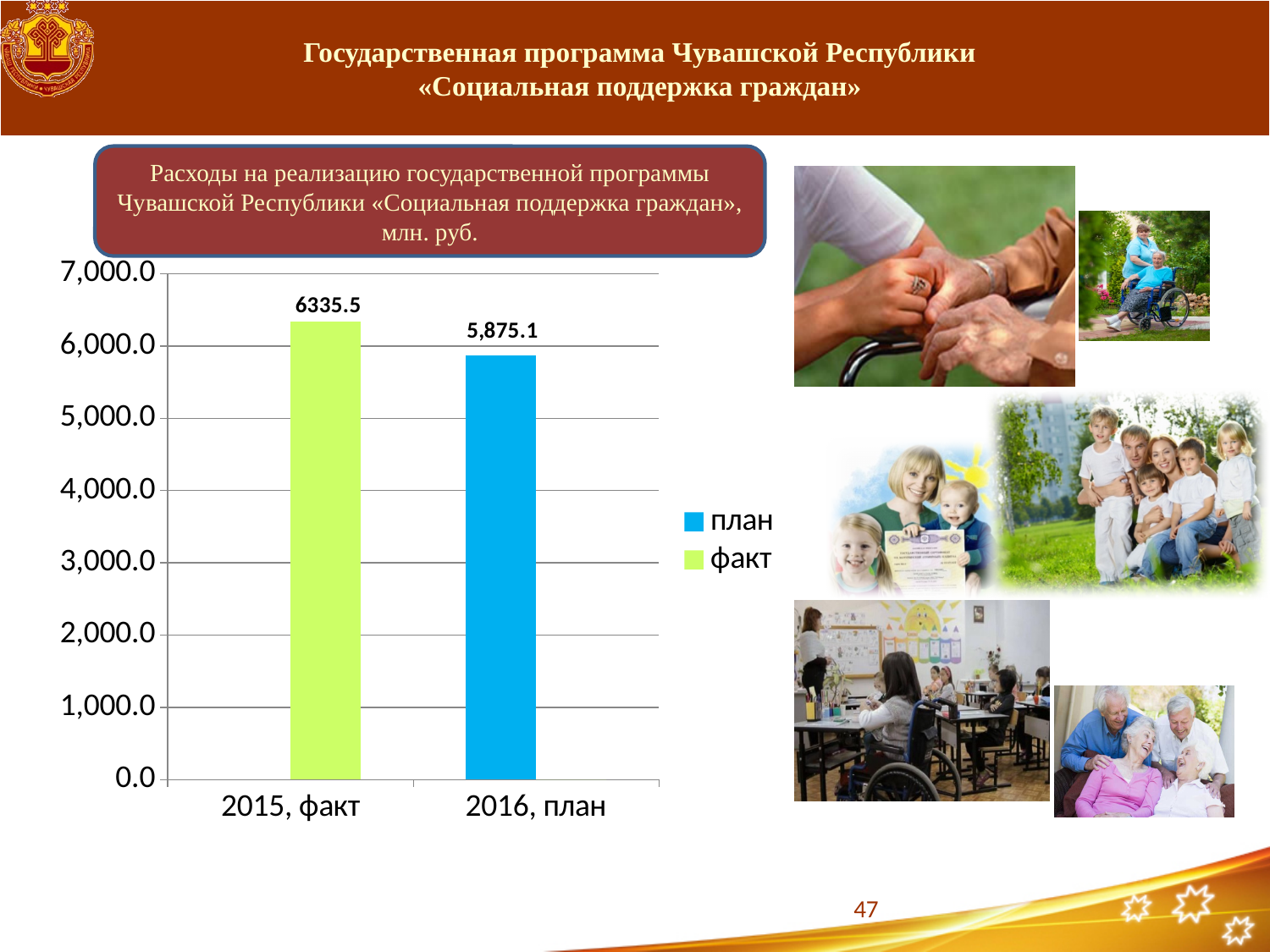
What is the value for 2016, план? 5,875.1 How many entries does the legend list? 2 What is the difference between the 2015, факт value and the 2016, план value? 460.4 How many bars are plotted on the chart? 2 Is the value for 2015, факт greater or less than 6,000.0? greater What kind of chart is shown on the slide? bar chart What is the value for 2015, факт? 6335.5 Which legend entry is shown in blue? план Which category has the lower value? 2016, план Is the value for 2015, факт larger or smaller than the value for 2016, план? larger Which category has the higher value? 2015, факт Is the value for 2016, план greater or less than 6,000.0? less